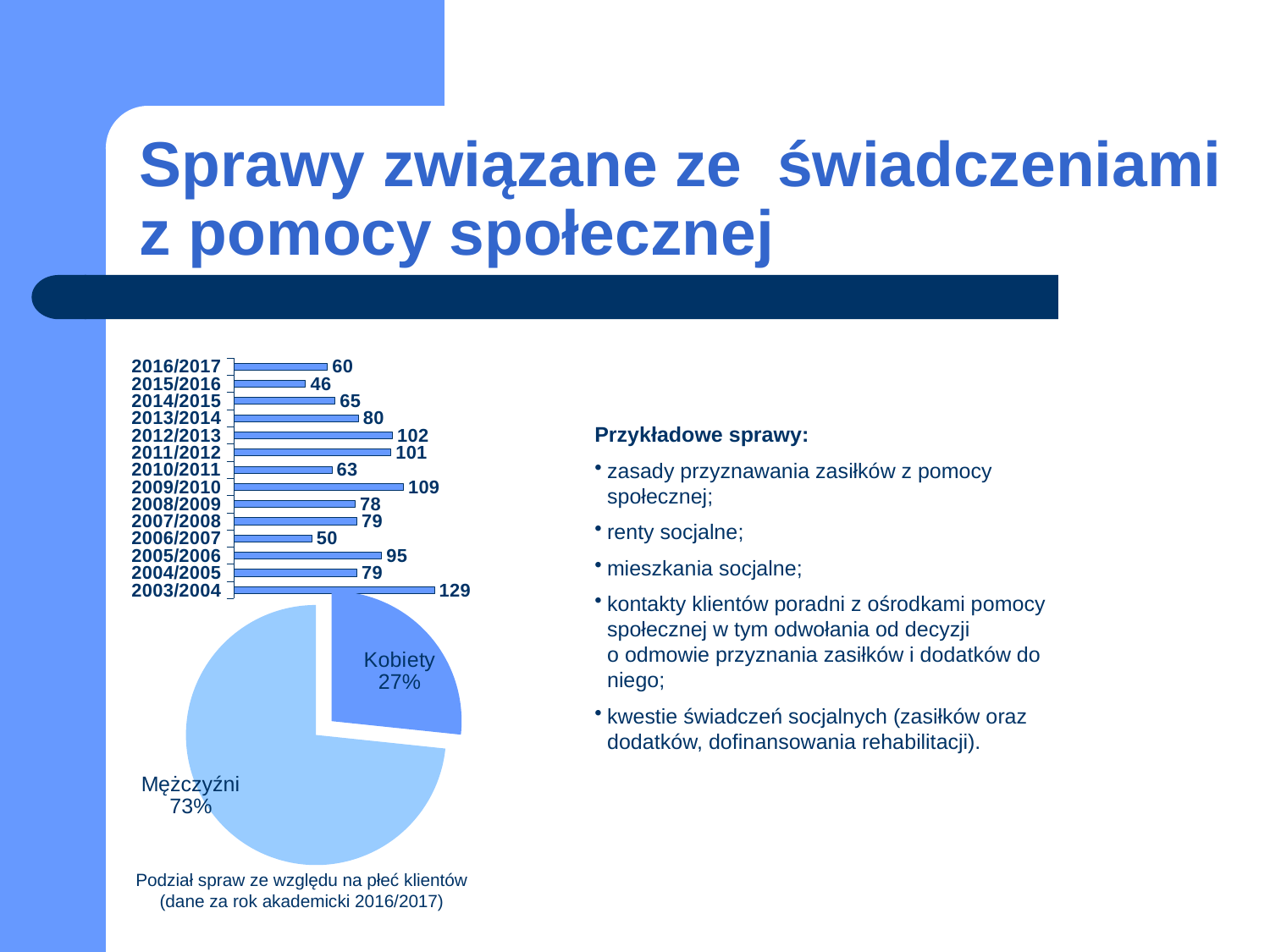
In the bar chart at the top left of the slide, what is the difference between the values for 2003/2004 and 2015/2016? 83 In the bar chart at the top left of the slide, which year has the lowest value? 2015/2016 What kind of chart is the chart at the top left of the slide? bar chart In the pie chart on the slide, which slice is larger, Kobiety or Mężczyźni? Mężczyźni In the bar chart at the top left of the slide, what is the value for 2016/2017? 60 In the bar chart at the top left of the slide, what is the value for 2003/2004? 129 In the bar chart at the top left of the slide, which year has the highest value? 2003/2004 In the bar chart at the top left of the slide, how many years are shown? 14 What is the caption below the pie chart on the slide? Podział spraw ze względu na płeć klientów (dane za rok akademicki 2016/2017) In the bar chart at the top left of the slide, which is larger, the value for 2009/2010 or the value for 2005/2006? 2009/2010 In the pie chart on the slide, what share is labelled Kobiety? 27% In the bar chart at the top left of the slide, what is the difference between the values for 2012/2013 and 2011/2012? 1